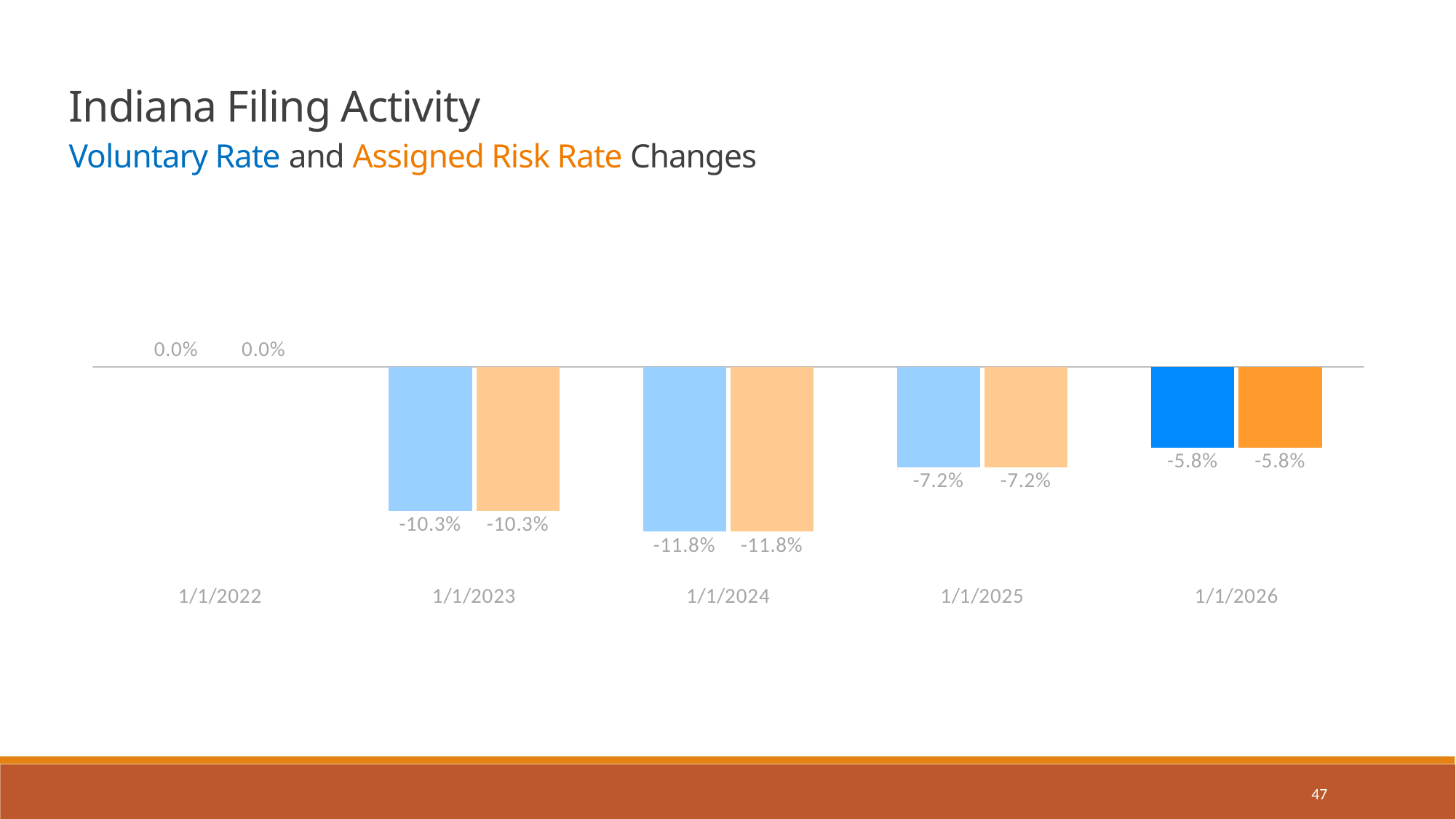
What is the Voluntary Rate change for 1/1/2022? 0.0% What is the Voluntary Rate change for 1/1/2023? -10.3% Is the Voluntary Rate change for 1/1/2023 larger or smaller than the change for 1/1/2025? smaller Which date has the highest Assigned Risk Rate change value? 1/1/2022 What is the Assigned Risk Rate change for 1/1/2026? -5.8% What is the Voluntary Rate change for 1/1/2025? -7.2% What is the Assigned Risk Rate change for 1/1/2024? -11.8% Which date has the largest rate decrease for the Voluntary Rate? 1/1/2024 How many dates are shown on the x axis of the chart? 5 What is the difference between the Voluntary Rate change for 1/1/2024 and for 1/1/2026? 6.0 percentage points Do the rate changes rise or fall from 1/1/2024 to 1/1/2026? rise What kind of chart is shown on the slide? bar chart